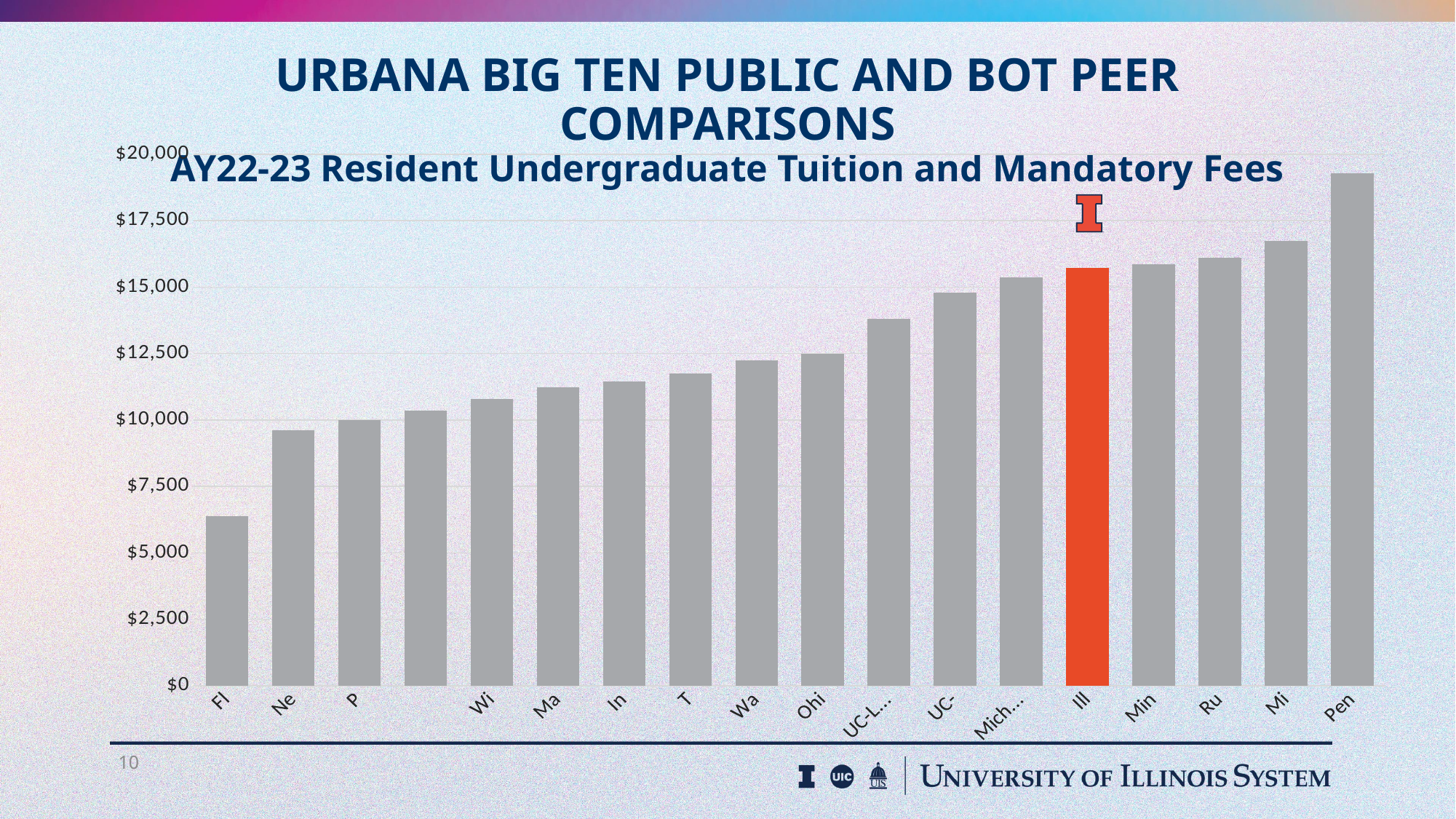
What kind of chart is shown on the slide? bar chart Do the bar values generally rise or fall from left to right along the x axis? rise Is the value for Ma greater or less than $10,000? greater Is the value for Fl greater or less than $7,500? less Is the value for Ne greater or less than $10,000? less How many bars are plotted in the chart? 18 Which is larger, the value for Ill or the value for Ne? Ill Which bar in the chart is highlighted in orange rather than grey? Ill Which category has the highest tuition and mandatory fees in the chart? Pen Which category has the lowest tuition and mandatory fees in the chart? Fl